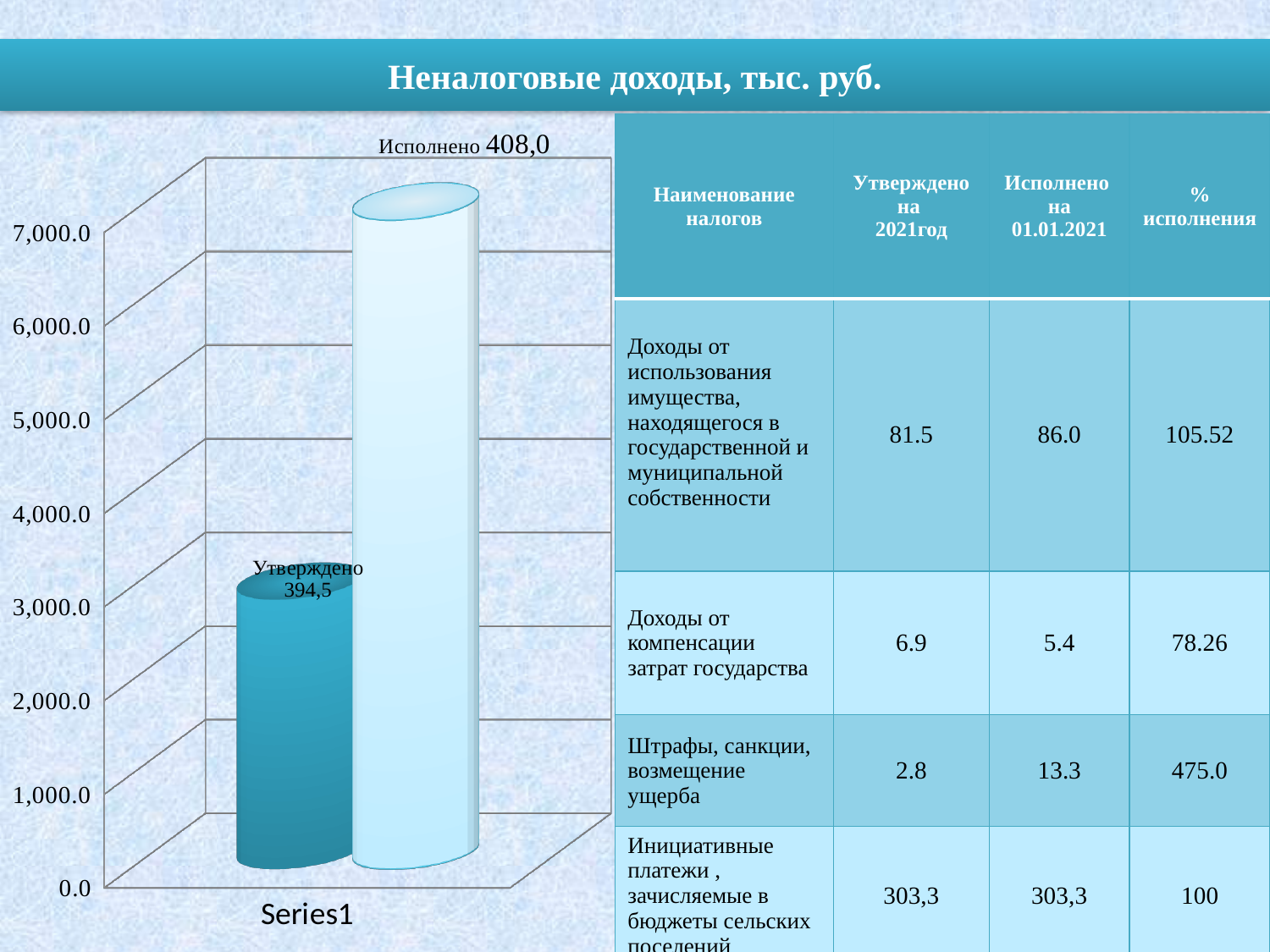
What value is printed for the Утверждено bar in the chart? 394,5 What is the highest tick value shown on the chart's vertical axis? 7,000.0 How many bars are plotted in the chart? 2 What is the title shown above the chart on the slide? Неналоговые доходы, тыс. руб. What kind of chart is shown on the left of the slide? bar chart What is the difference between the printed values for Исполнено (408,0) and Утверждено (394,5)? 13,5 Which bar in the chart has the higher printed value, Утверждено or Исполнено? Исполнено What value is printed for the Исполнено bar in the chart? 408,0 Is the printed value for Исполнено larger or smaller than the printed value for Утверждено? larger Which bar in the chart has the lower printed value? Утверждено